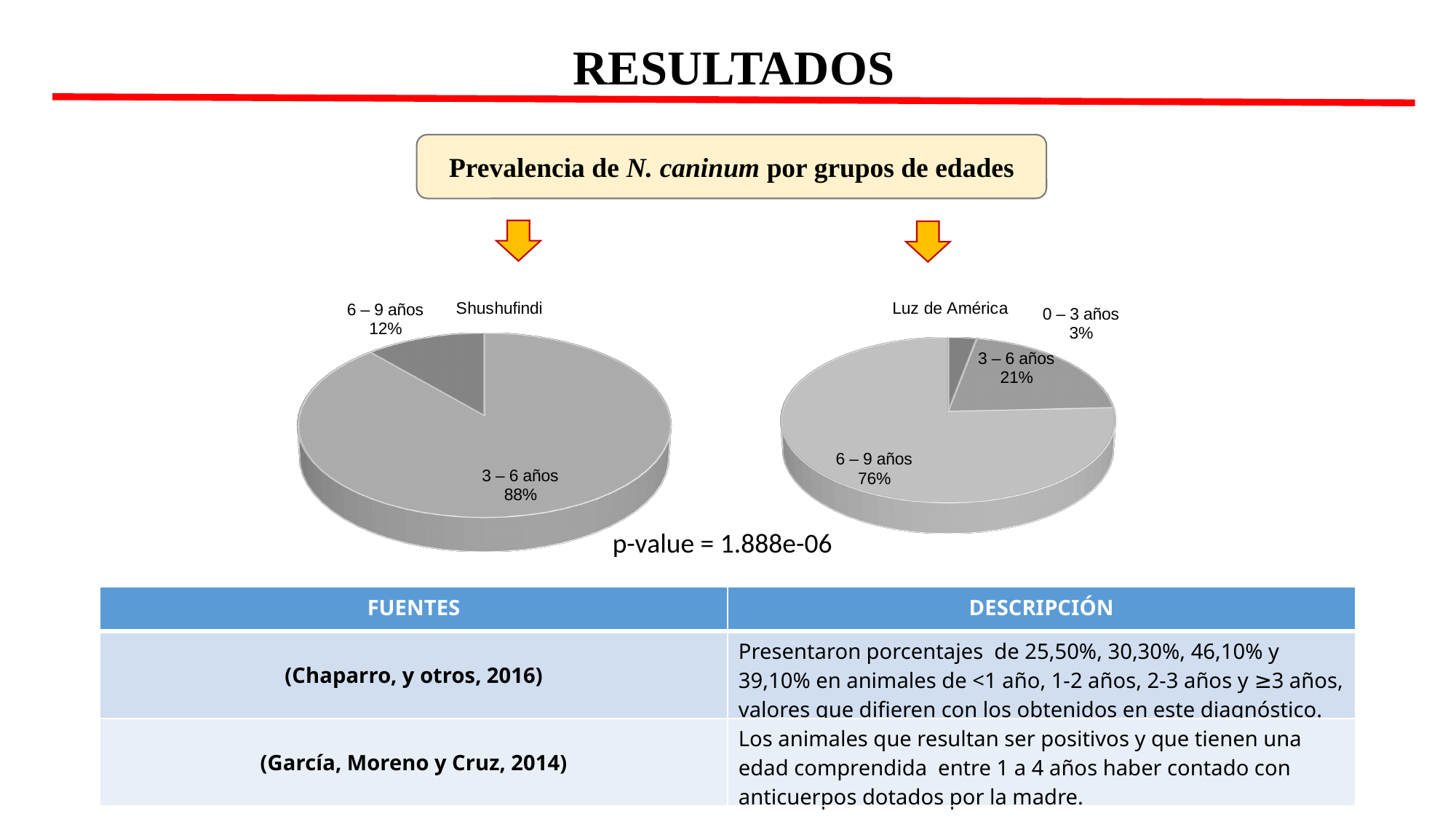
In the Shushufindi pie chart, what share does the 3 – 6 años group have? 88% In the Luz de América pie chart, what share does the 6 – 9 años group have? 76% In the Luz de América pie chart, which age group has the largest share? 6 – 9 años In the Shushufindi pie chart, which age group has the largest share? 3 – 6 años In the Shushufindi pie chart, what share does the 6 – 9 años group have? 12% In the Luz de América pie chart, what is the difference in percentage points between the 6 – 9 años and 3 – 6 años groups? 55 In the Shushufindi pie chart, what is the difference in percentage points between the 3 – 6 años and 6 – 9 años groups? 76 In the Luz de América pie chart, what share does the 3 – 6 años group have? 21% In the Luz de América pie chart, which age group has the smallest share? 0 – 3 años How many age groups are shown in the Luz de América pie chart? 3 In the Luz de América pie chart, what share does the 0 – 3 años group have? 3% What type of chart is used for Shushufindi? Pie chart